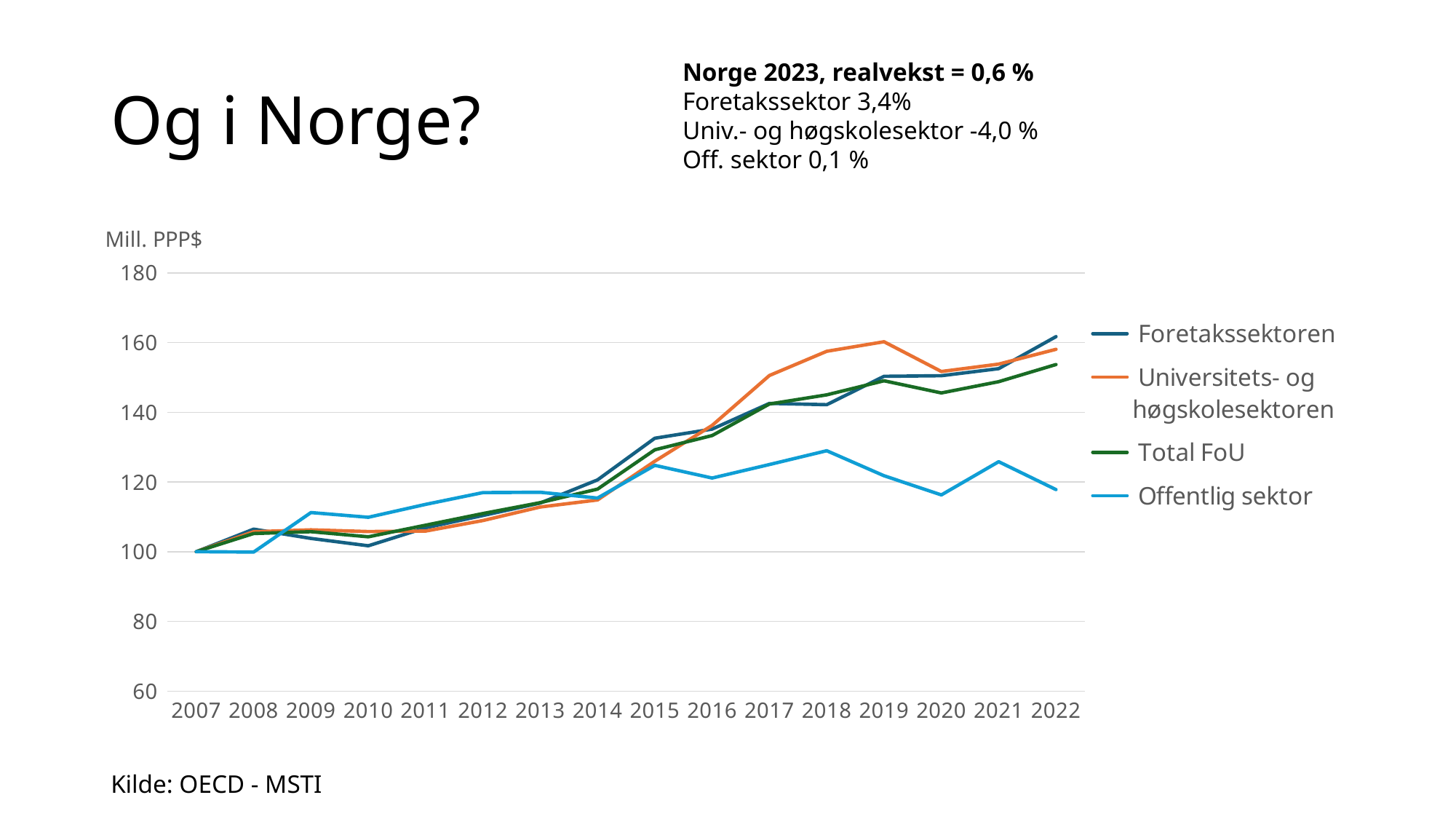
What kind of chart is shown on the slide? line chart Is the value for Foretakssektoren in 2015 greater or less than 120? greater Which series has the lowest value in 2022? Offentlig sektor How many years are shown along the x axis of the chart? 16 In 2020, which is larger: Total FoU or Offentlig sektor? Total FoU How many series does the chart legend list? 4 What is the value of Total FoU in 2007? 100 What unit is shown on the y axis of the chart? Mill. PPP$ Is the value for Universitets- og høgskolesektoren in 2018 greater or less than 140? greater Which series has the highest value in 2019? Universitets- og høgskolesektoren Is the value for Offentlig sektor in 2020 greater or less than 120? less Does the Foretakssektoren series rise or fall overall from 2007 to 2022? rise